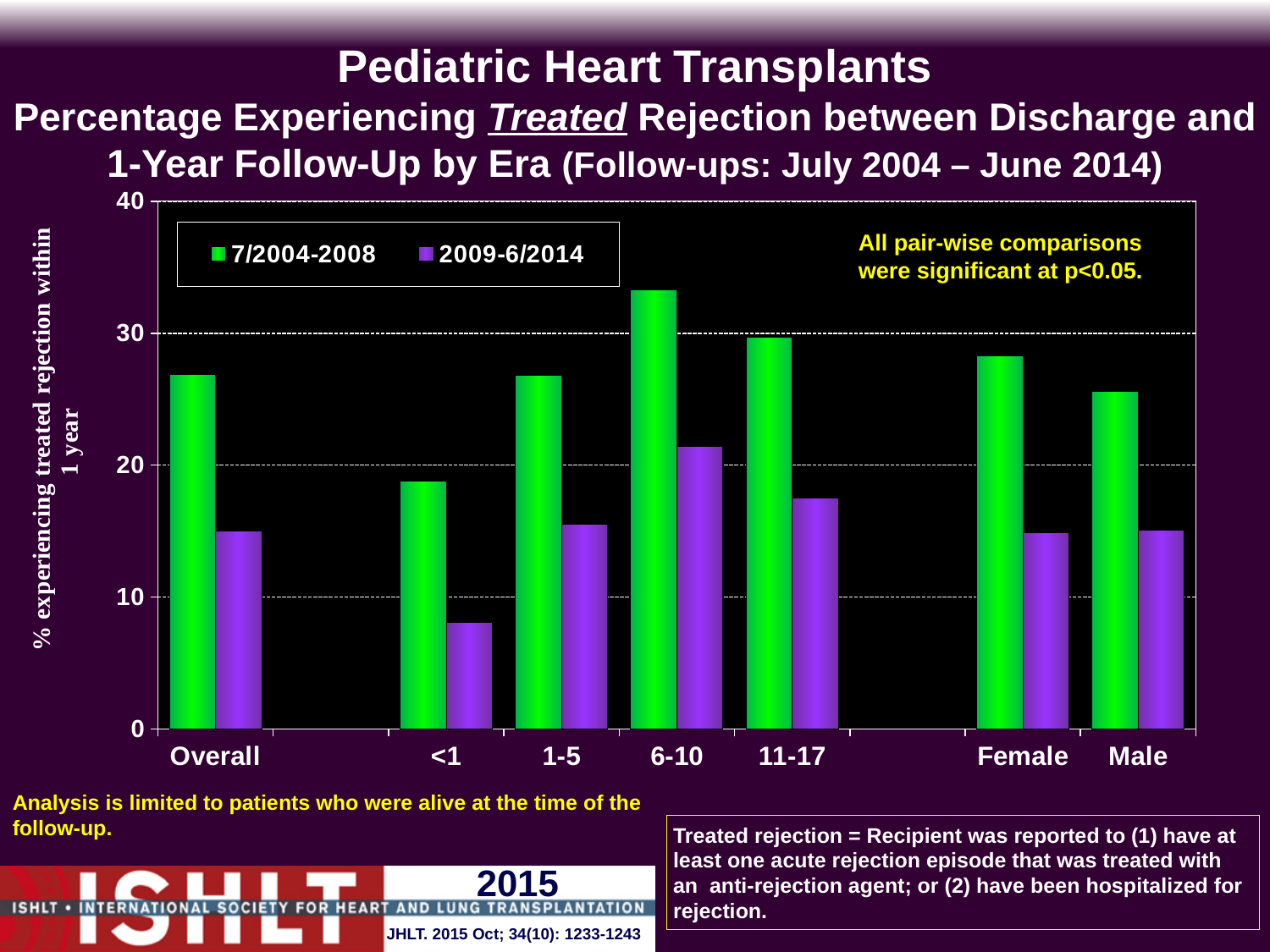
Which category has the highest value for the 7/2004-2008 series? 6-10 Which is larger for the 2009-6/2014 series: 6-10 or 11-17? 6-10 What kind of chart is shown on the slide? bar chart Is the 2009-6/2014 value for 11-17 greater or less than 20? less Which category has the lowest value for the 7/2004-2008 series? <1 How many series does the legend list? 2 Which category has the lowest value for the 2009-6/2014 series? <1 Which colour represents the 2009-6/2014 series in the legend? purple Is the 2009-6/2014 value for <1 greater or less than 10? less For the 2009-6/2014 series, do the values rise or fall from <1 to 6-10? rise How many categories are shown along the x axis? 7 Is the 7/2004-2008 value for 6-10 greater or less than 30? greater